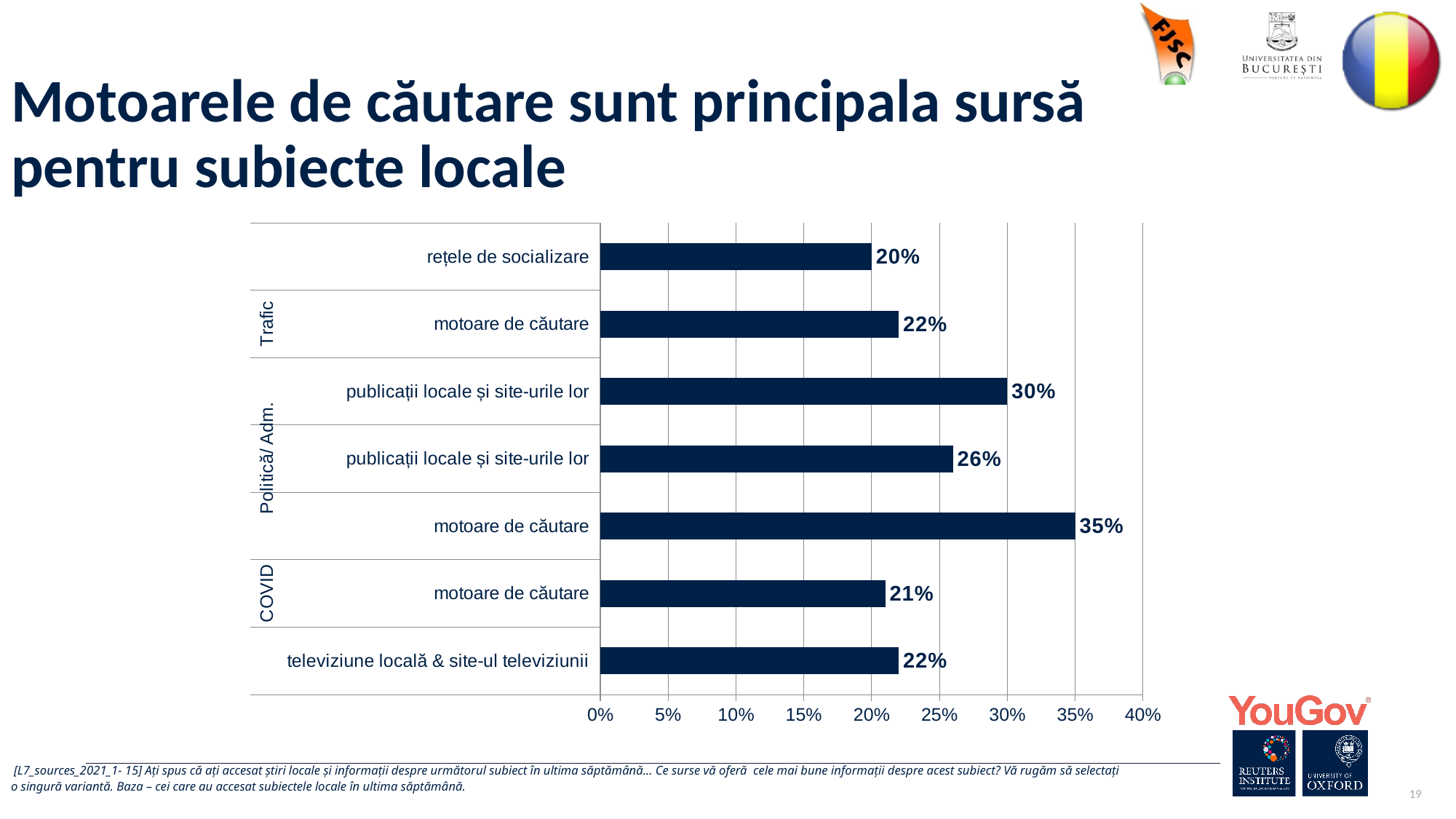
What is the value for televiziune locală & site-ul televiziunii? 22% Which bar has the lowest value on the chart? rețele de socializare (Trafic), 20% What is the value for motoare de căutare in the COVID group? 21% Which bar has the highest value on the chart? motoare de căutare (Politică/ Adm.), 35% What is the value for motoare de căutare in the Politică/ Adm. group? 35% What is the value for rețele de socializare in the Trafic group? 20% How many bars are plotted on the chart? 7 What kind of chart is shown on the slide? bar chart What is the maximum value shown on the horizontal axis? 40% Is the value for motoare de căutare in the Politică/ Adm. group greater or less than 30%? greater Which is larger: the first publicații locale și site-urile lor bar (30%) or the second one (26%)? the first, 30% What is the difference between motoare de căutare in the Politică/ Adm. group (35%) and motoare de căutare in the Trafic group (22%)? 13%